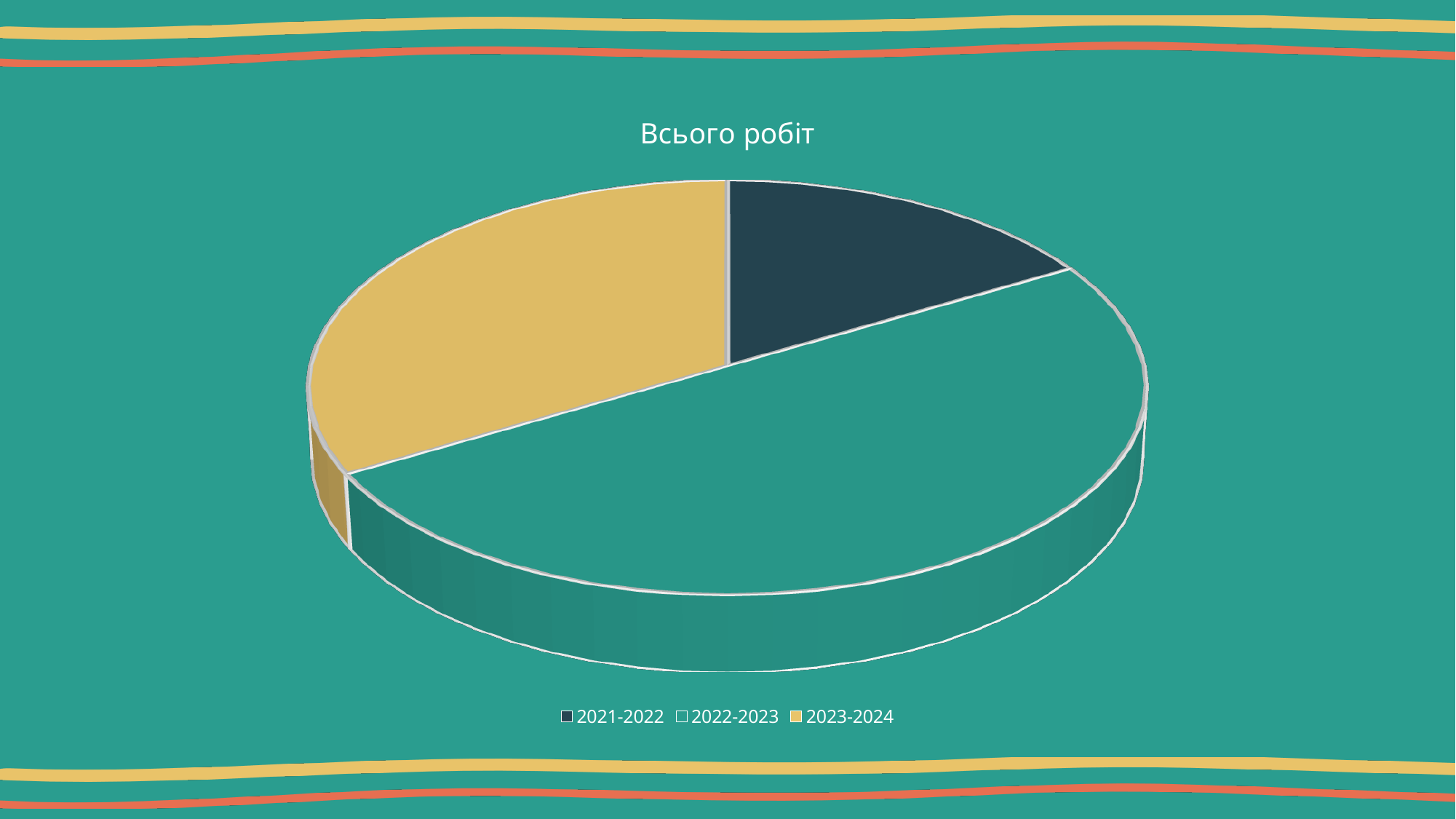
Which category is shown in yellow in the pie chart? 2023-2024 Which slice is larger, 2022-2023 or 2023-2024? 2022-2023 Which legend entry is listed first? 2021-2022 Which category has the largest slice of the pie? 2022-2023 What kind of chart is shown on the slide? Pie chart Which slice is larger, 2023-2024 or 2021-2022? 2023-2024 How many slices does the pie chart have? 3 How many entries does the legend list? 3 What is the title of the chart? Всього робіт Which category has the smallest slice of the pie? 2021-2022